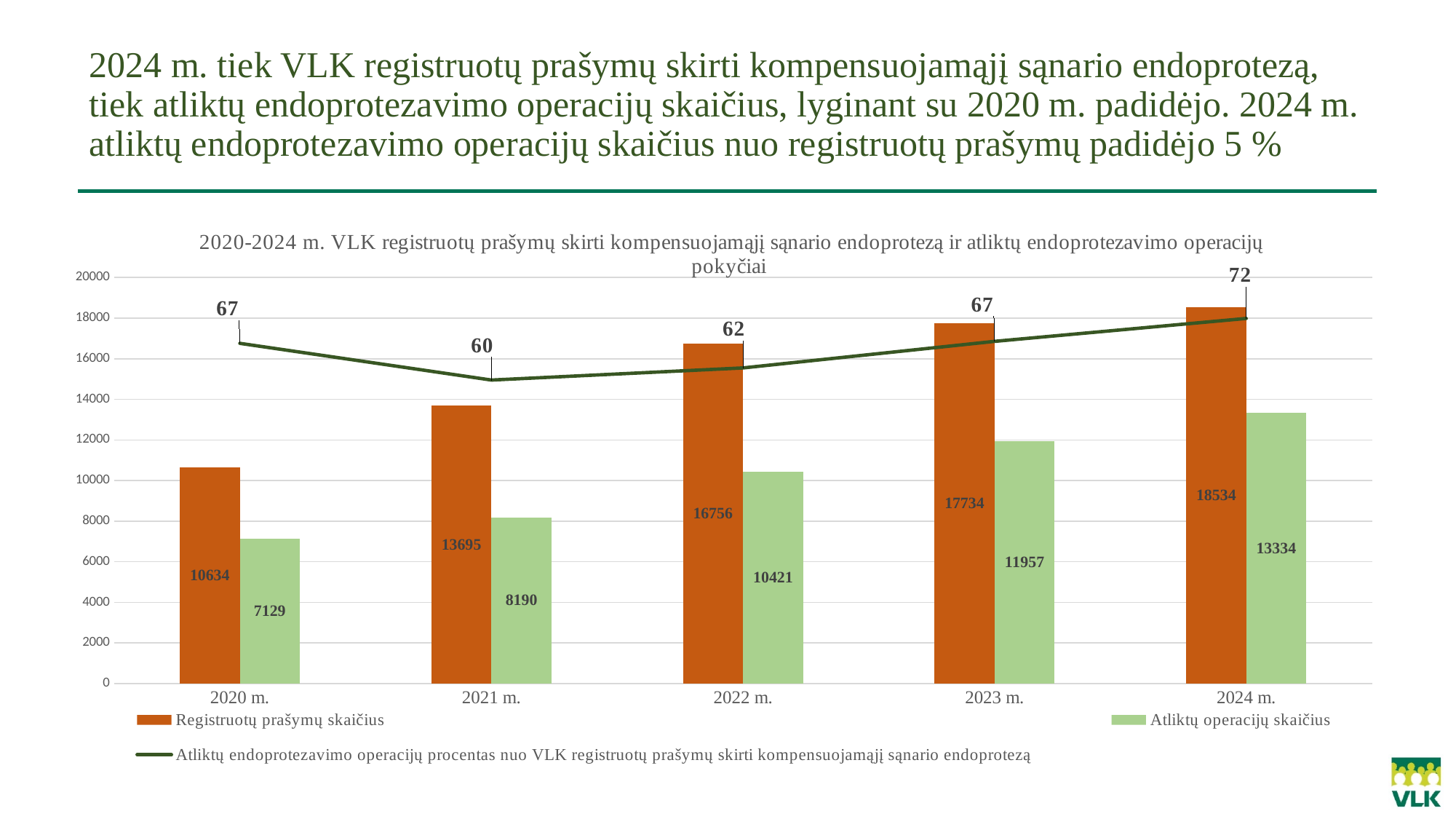
Which year has the highest value of Atliktų operacijų skaičius? 2024 m. Which year has the lowest value on the line series (Atliktų endoprotezavimo operacijų procentas)? 2021 m. How many years are shown on the x axis? 5 What kind of chart is this? Combined bar and line chart What percentage does the line series show for 2020 m.? 67 Which is larger: Registruotų prašymų skaičius in 2021 m. or Atliktų operacijų skaičius in 2024 m.? Registruotų prašymų skaičius in 2021 m. How many series does the legend list? 3 What colour are the bars for Atliktų operacijų skaičius? Light green What is the difference between Registruotų prašymų skaičius and Atliktų operacijų skaičius in 2022 m.? 6335 What is the value of Registruotų prašymų skaičius for 2024 m.? 18534 What is the value of Atliktų operacijų skaičius for 2021 m.? 8190 Do the values of Registruotų prašymų skaičius rise or fall from 2020 m. to 2024 m.? Rise